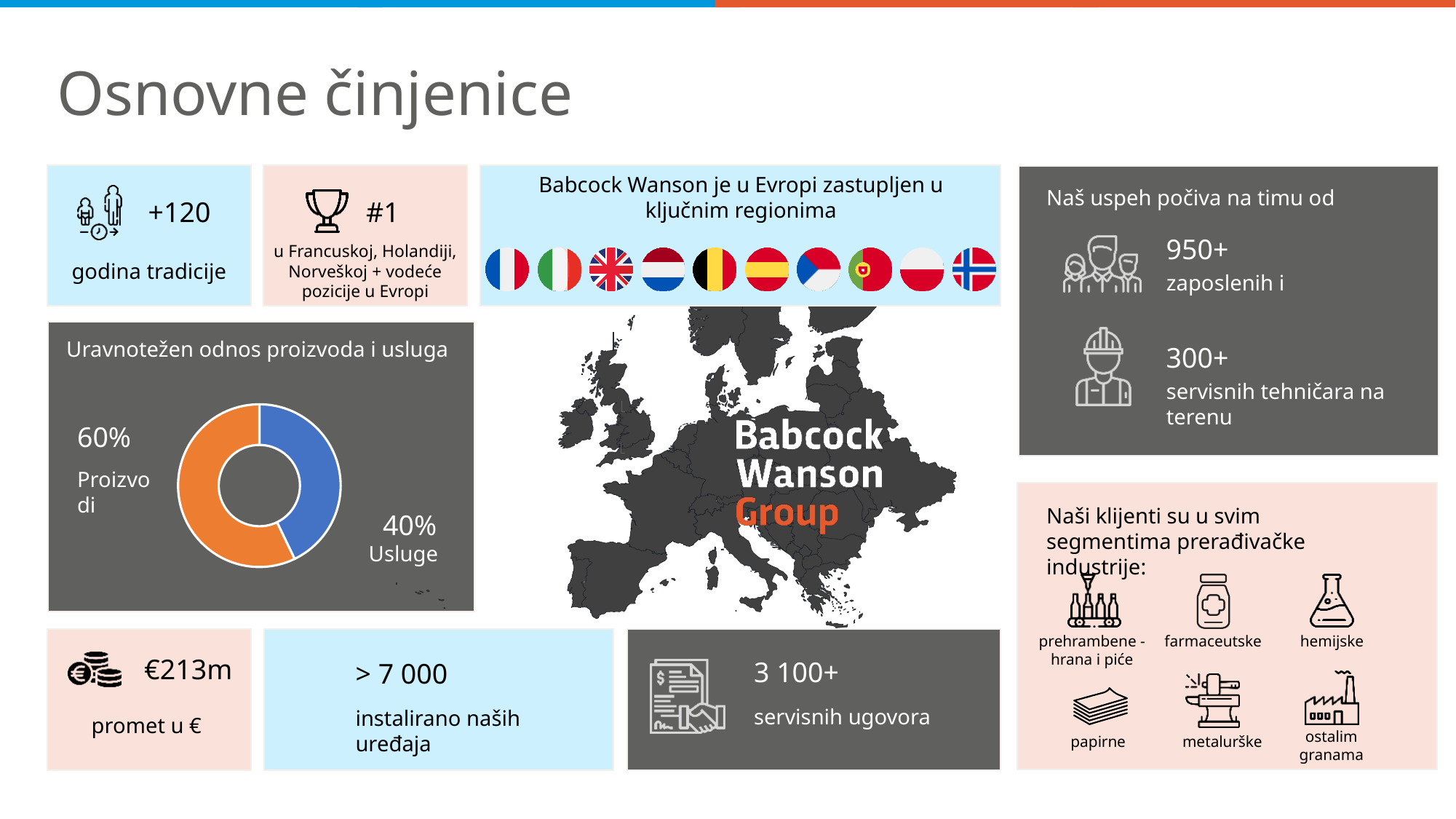
What share of the donut chart is labelled "Proizvodi"? 60% Which segment of the donut chart is the smallest? Usluge What is the difference in percentage points between the Proizvodi and Usluge segments of the donut chart? 20% Which segment of the donut chart is larger, Proizvodi or Usluge? Proizvodi What is the title shown above the donut chart? Uravnotežen odnos proizvoda i usluga What kind of chart is shown under the heading "Uravnotežen odnos proizvoda i usluga"? Pie chart (donut) How many segments does the donut chart have? 2 What colour is the Proizvodi segment of the donut chart? Orange What share of the donut chart is labelled "Usluge"? 40% Which segment of the donut chart is the largest? Proizvodi Is the share for Proizvodi in the donut chart greater or less than 50%? greater